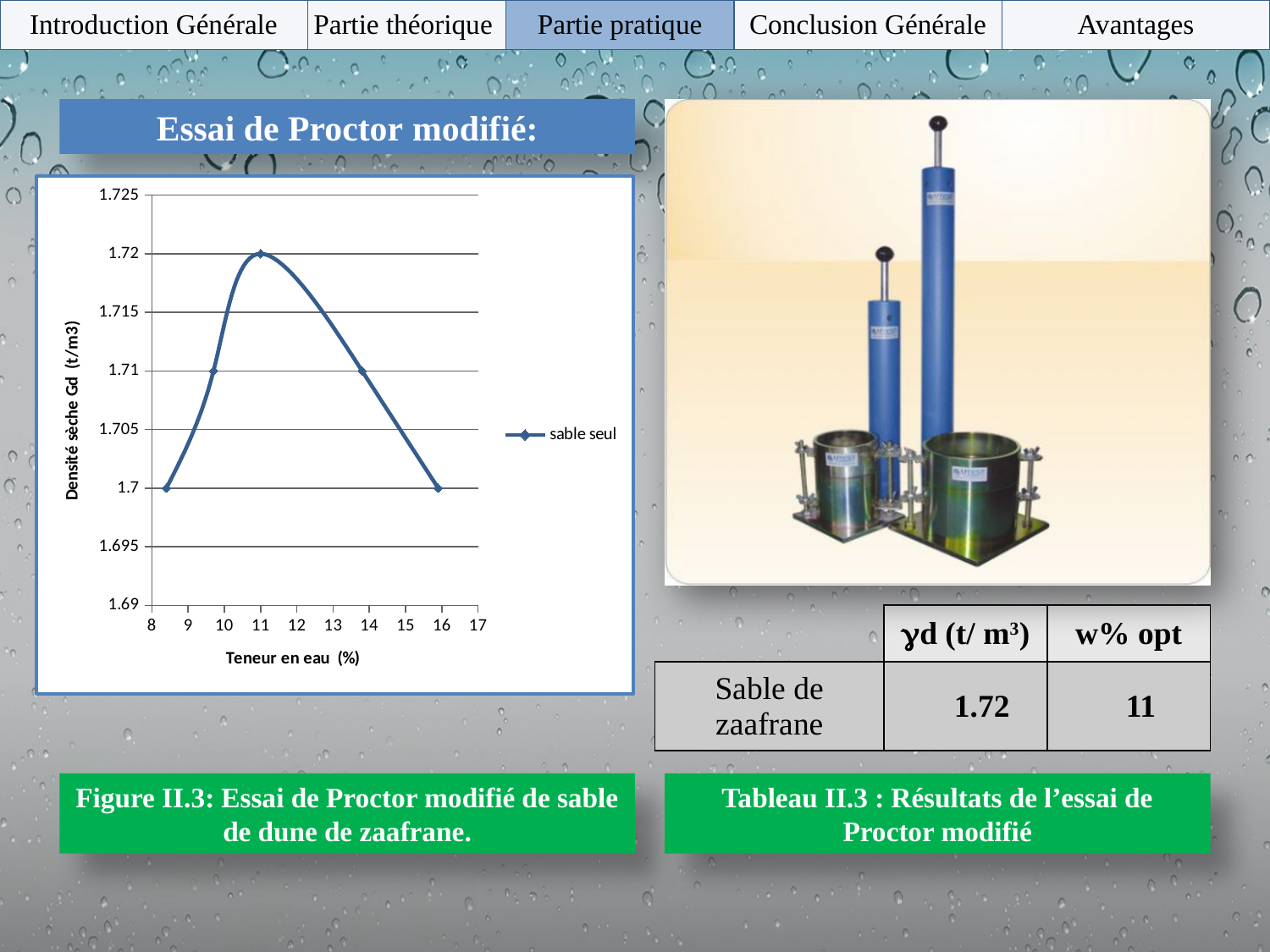
At what water content (Teneur en eau) does the curve reach its maximum? 11 How does the dry density change as the water content increases from 8 to 17%? it rises to a peak at 11% then falls How many data points are plotted on the curve? 5 Is the dry density at a water content of 11% greater or less than 1.715? greater How many series does the chart legend list? 1 What is the highest dry density value reached by the curve? 1.72 Is the dry density at a water content of 16% greater or less than 1.705? less Which is larger: the dry density at about 11% water content or at about 16% water content? at 11% What kind of chart is shown on the slide? line chart What is the name of the series shown in the chart legend? sable seul What is the title of the x axis of the chart? Teneur en eau (%) What is the lowest dry density value plotted on the curve? 1.7